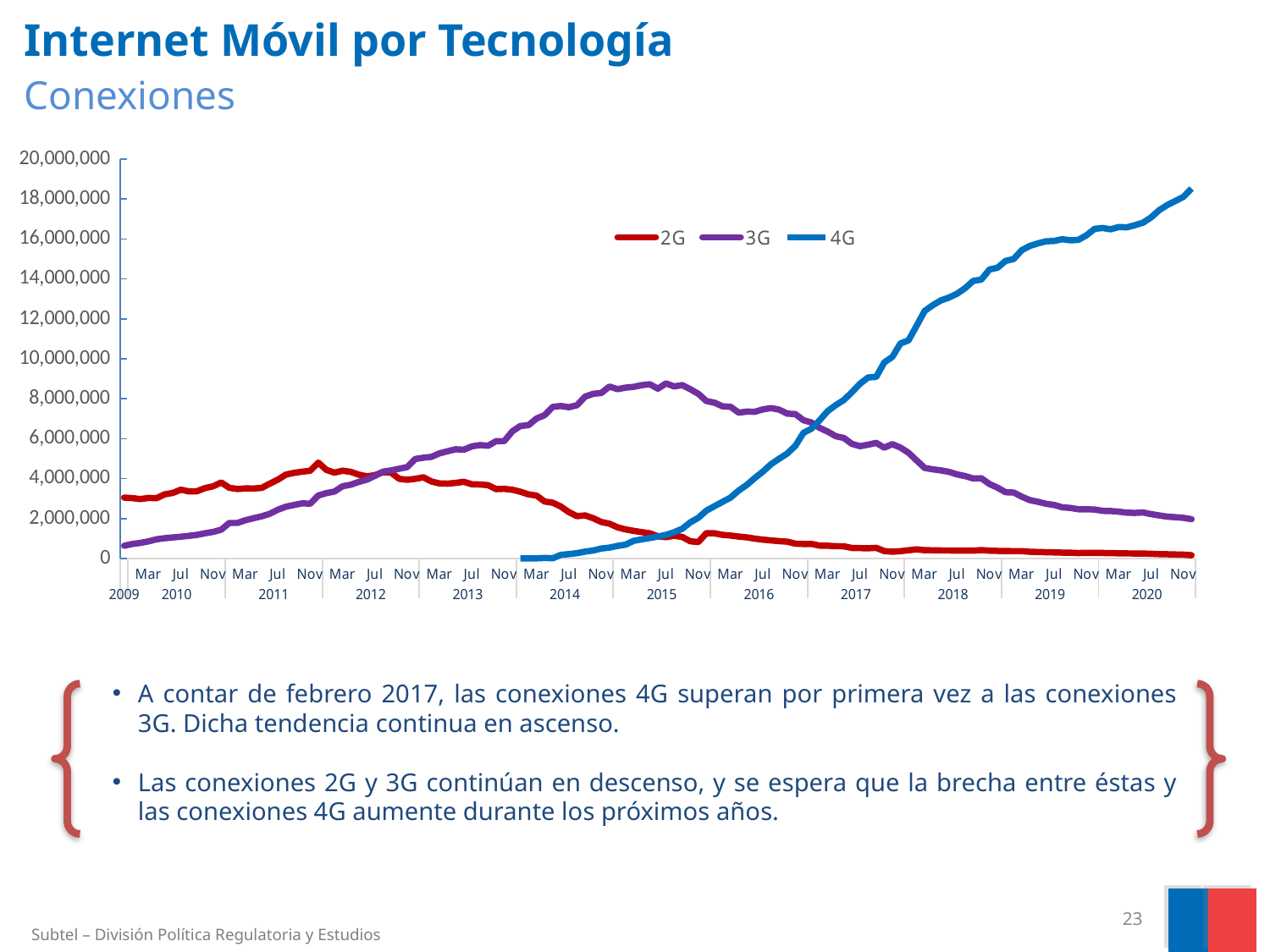
Does the 4G line rise or fall from 2014 to 2020? Rises What colour is the 4G line? Blue Is the value for 3G at Nov 2020 greater or less than 4,000,000? less Which series has the lowest value at Nov 2020? 2G Is the value for 2G at Nov 2020 greater or less than 2,000,000? less What are the series listed in the legend? 2G, 3G, 4G Is the value for 4G at Nov 2020 greater or less than 16,000,000? greater How many series does the legend list? 3 Which series has the highest value at Nov 2020? 4G Does the 2G line rise or fall from 2012 to 2020? Falls What kind of chart is shown on the slide? Line chart Which is larger at Mar 2014, 3G or 4G? 3G